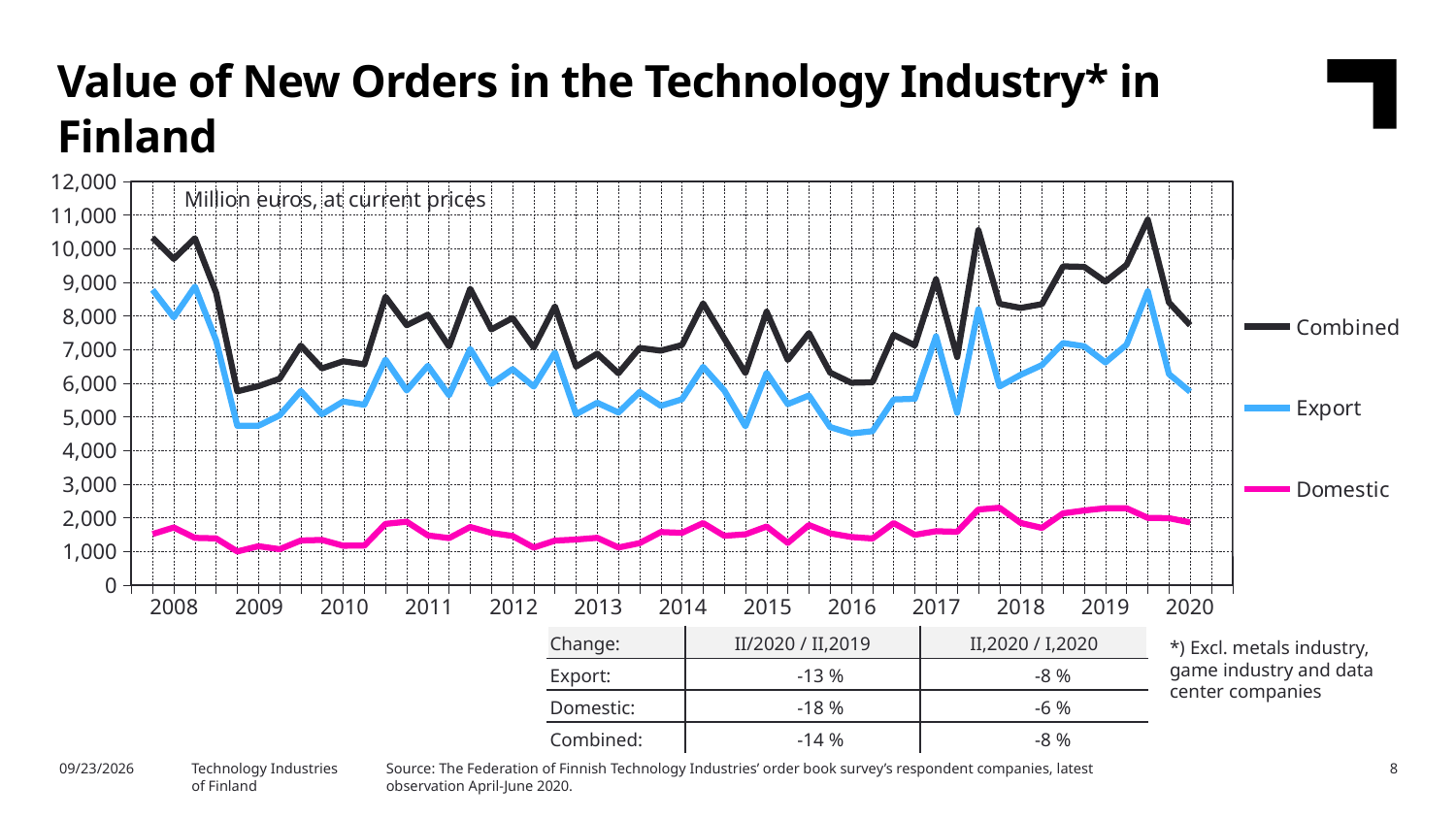
Is the value for Combined at its peak in 2019 greater or less than 10,000? greater What unit label is shown inside the chart area? Million euros, at current prices Is the value for Domestic in 2020 greater or less than 3,000? less Is the value for Export at its lowest point in 2016 greater or less than 5,000? less How many series does the legend list? 3 Does the Combined series rise or fall overall from 2016 to 2019? Rise How many years are labelled on the x axis? 13 What kind of chart is shown on the slide? Line chart Which series has the highest values throughout the chart? Combined Which is larger in 2020, the Export value or the Domestic value? Export Which series has the lowest values throughout the chart? Domestic